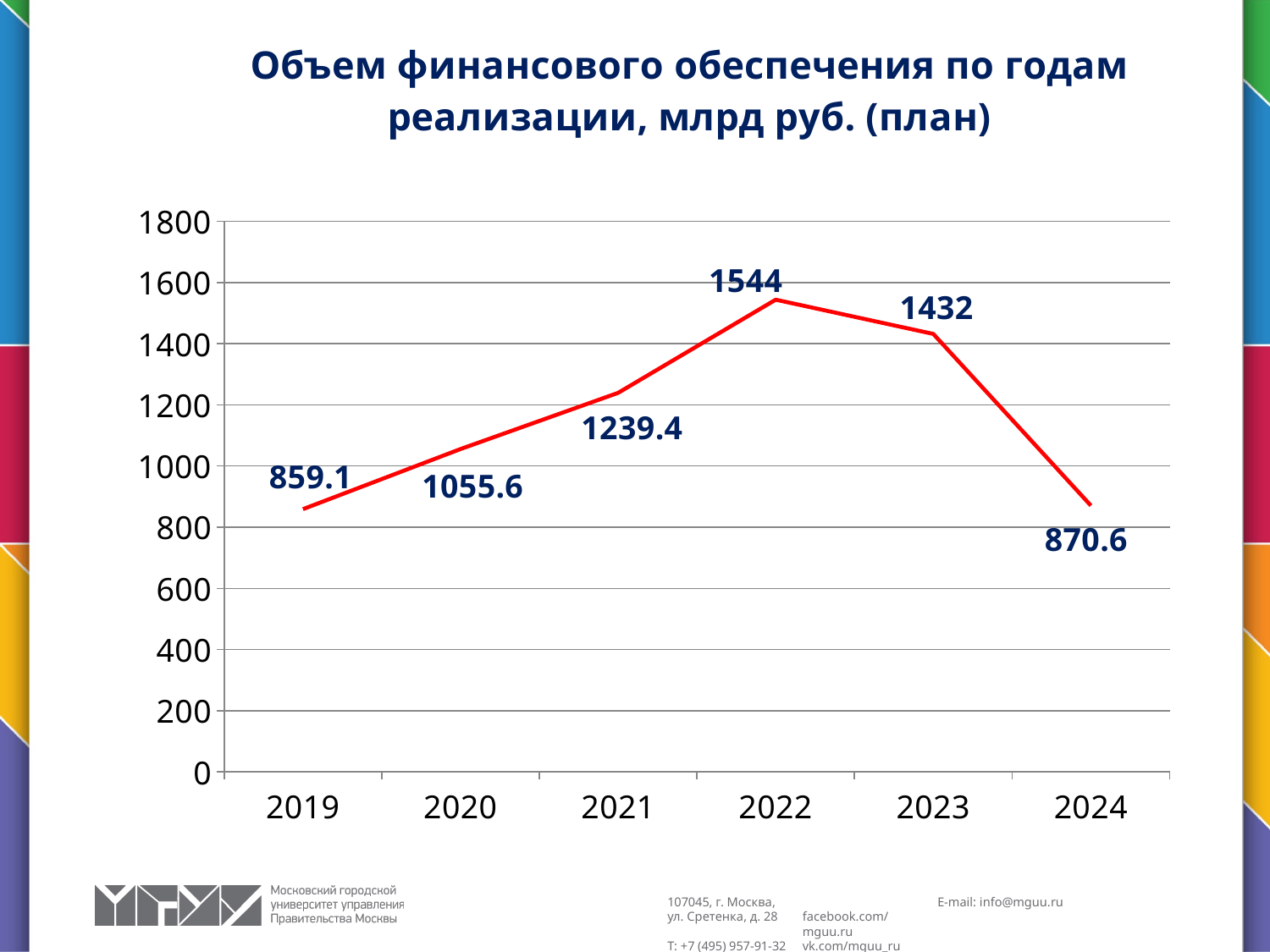
Which year has the lowest value? 2019 What is the value for 2019? 859.1 Which is larger, the value for 2023 or the value for 2021? 2023 What is the difference between the values for 2022 and 2023? 112 Which year has the highest value? 2022 What is the value for 2024? 870.6 Do the values rise or fall from 2019 to 2022? rise How many years are plotted on the chart? 6 What is the value for 2021? 1239.4 What is the value for 2022? 1544 What kind of chart is shown on the slide? line chart What is the difference between the values for 2020 and 2019? 196.5